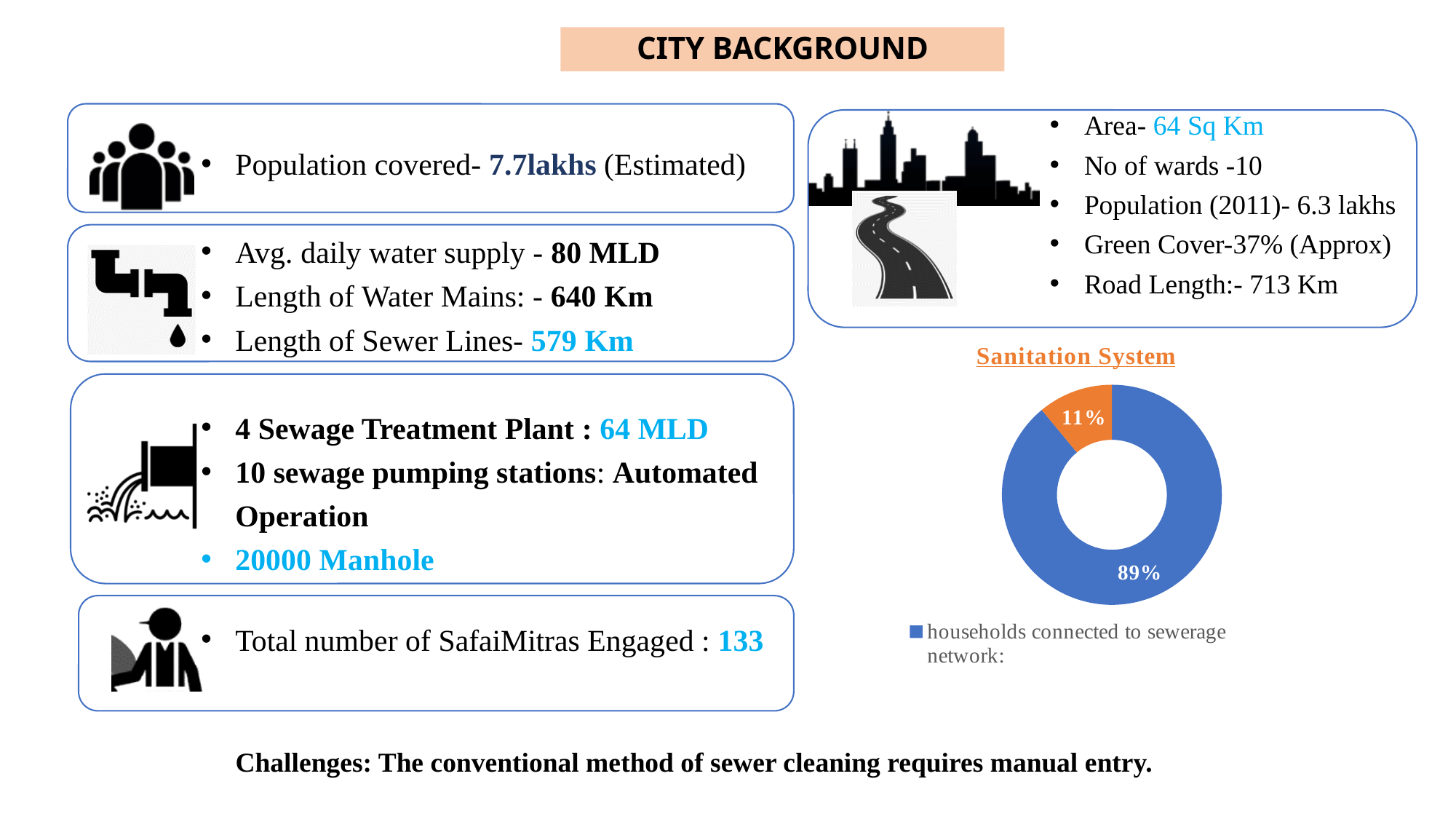
In the Sanitation System chart, how many slices does the doughnut have? 2 In the Sanitation System chart, what colour is the slice for households connected to the sewerage network? Blue In the Sanitation System chart, what is the value of the smallest slice? 11% In the Sanitation System chart, what is the value shown on the orange slice? 11% In the Sanitation System chart, is the share of households connected to the sewerage network greater or less than 50%? greater In the Sanitation System chart, what is the value of the largest slice? 89% In the Sanitation System chart, what is the difference in percentage points between the blue slice and the orange slice? 78 percentage points How many entries does the legend of the Sanitation System chart list? 1 What is the title of the chart on the right side of the slide? Sanitation System What type of chart is shown under the title "Sanitation System"? Doughnut chart In the Sanitation System chart, what percentage of households are connected to the sewerage network? 89% In the Sanitation System chart, which slice is larger, the blue one or the orange one? The blue one